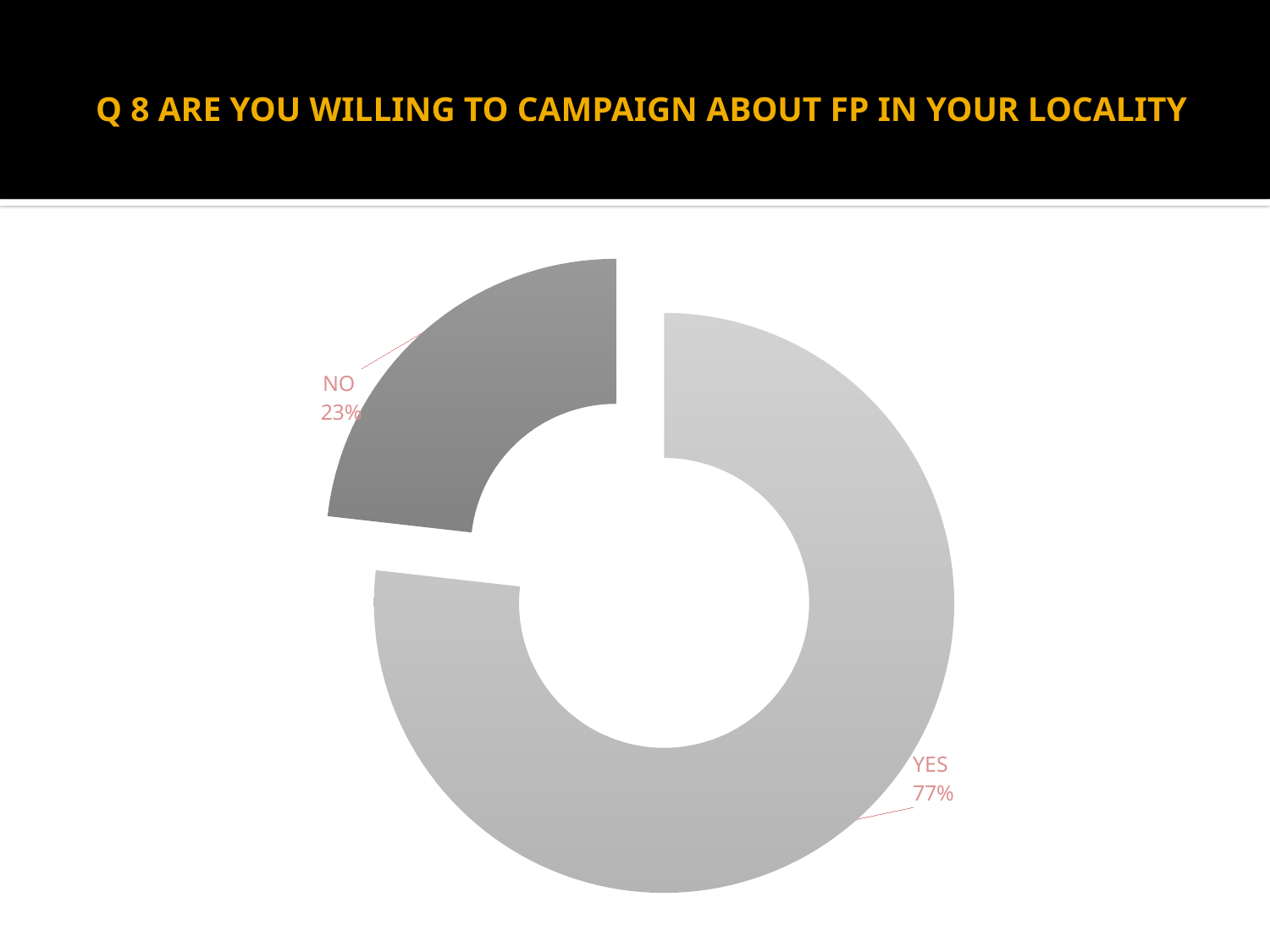
Which response has the largest share? YES Which response has the smallest share? NO What is the difference in percentage points between YES and NO? 54 How many categories are shown in the chart? 2 What is the title of the slide? Q 8 ARE YOU WILLING TO CAMPAIGN ABOUT FP IN YOUR LOCALITY Which is larger, the share for YES or the share for NO? YES Which slice is shown in the darker grey colour? NO What percentage of respondents answered NO? 23% What share of the chart does the YES slice represent? 77% What percentage of respondents answered YES? 77% What kind of chart is shown on the slide? Doughnut chart